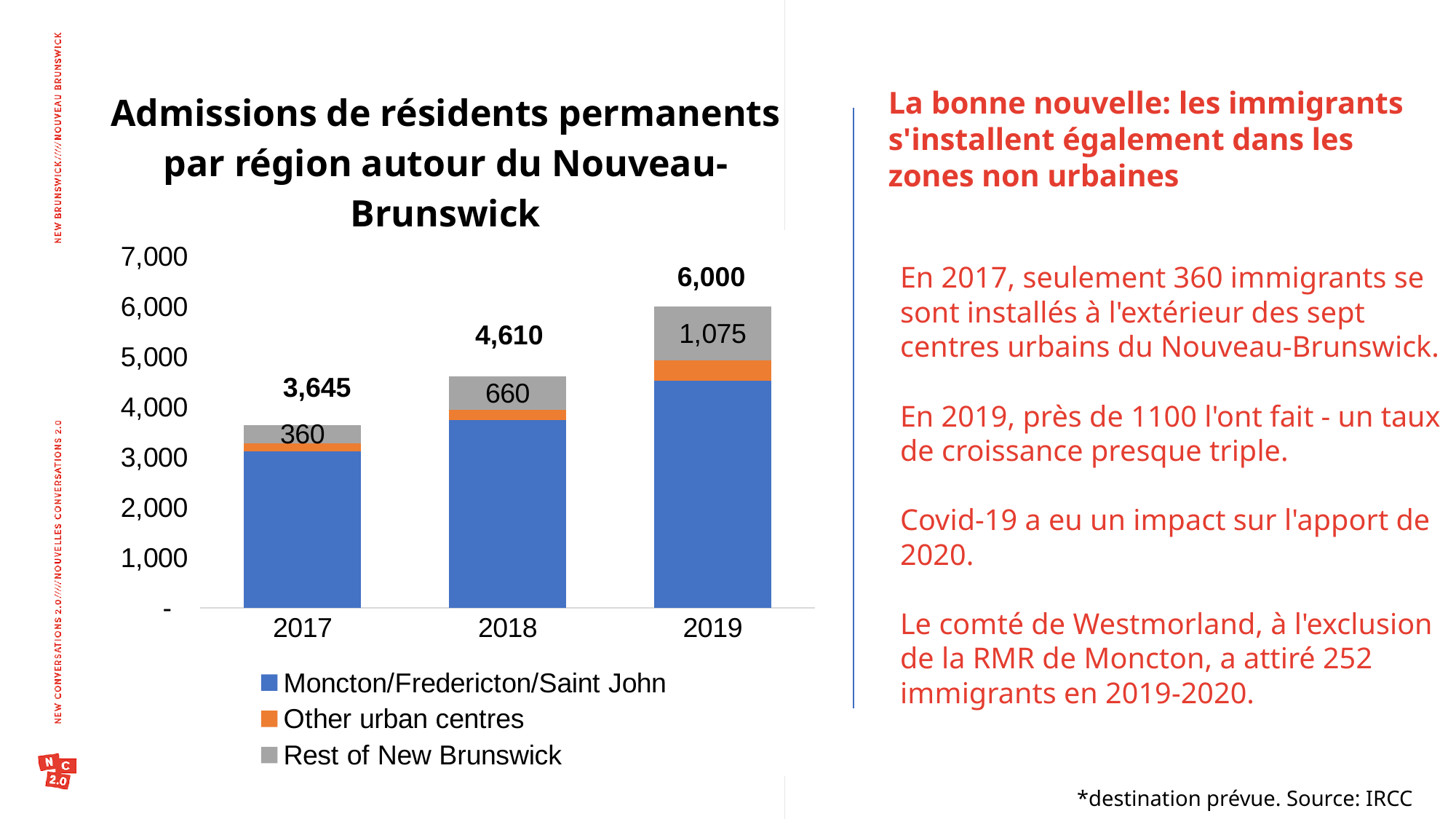
What is the difference between the total admissions in 2019 and 2017? 2,355 How many years are shown on the x axis? 3 What is the total number of permanent resident admissions shown for 2017? 3,645 What is the total number of permanent resident admissions shown for 2019? 6,000 Which year has the lowest value for Rest of New Brunswick? 2017 How many series does the legend list? 3 What kind of chart is shown on the slide? Stacked bar chart Is the total for 2018 greater or less than 5,000? less Which year has the highest total admissions? 2019 What is the value for Rest of New Brunswick in 2019? 1,075 By how much did the Rest of New Brunswick value increase from 2017 to 2019? 715 What is the value for Rest of New Brunswick in 2018? 660